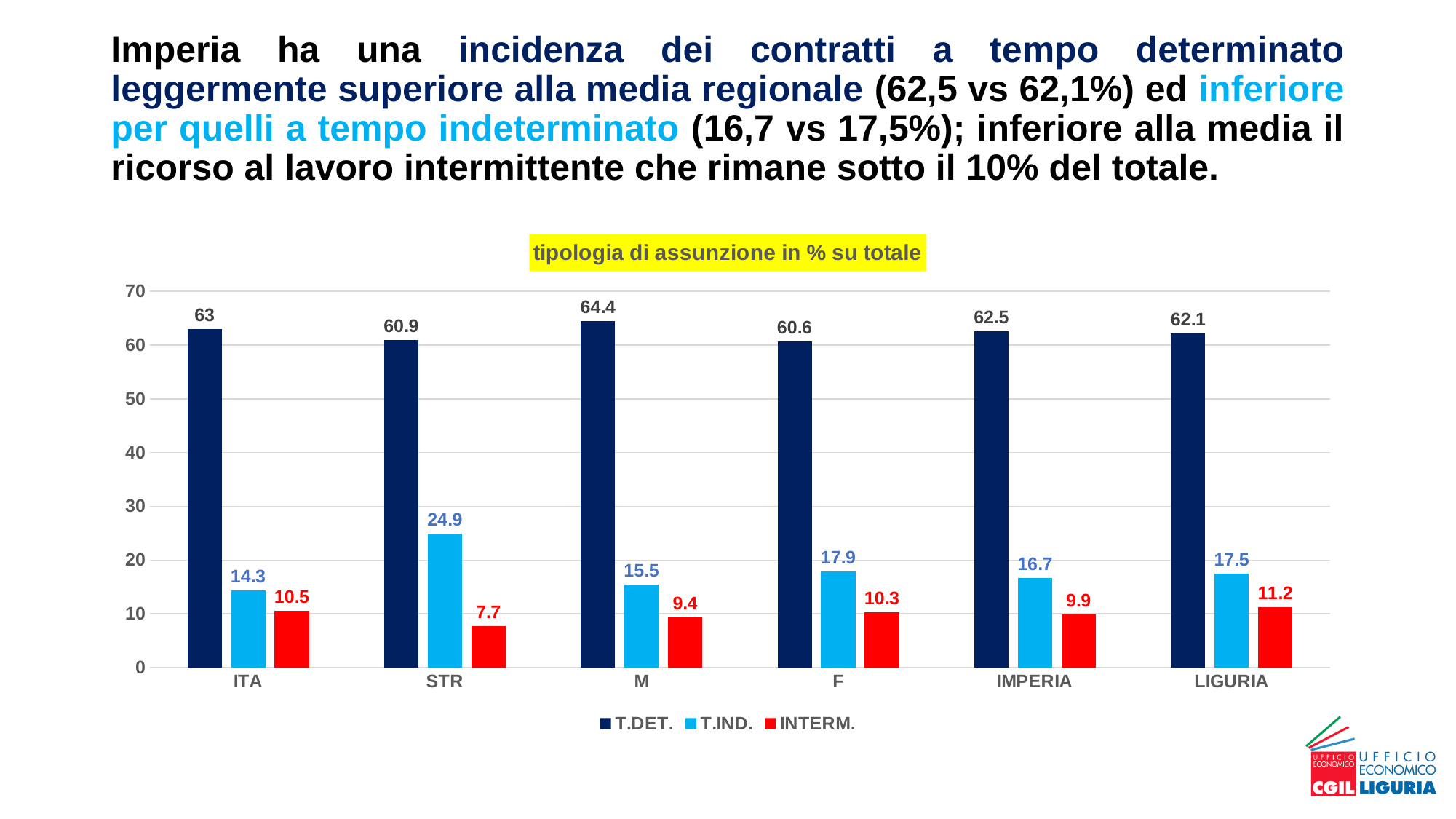
Is the T.IND. value for STR greater or less than 20? greater Which category has the highest T.DET. value? M What kind of chart is shown? bar chart Which category has the lowest INTERM. value? STR What is the T.DET. value for IMPERIA? 62.5 What is the T.IND. value for STR? 24.9 How many categories are shown on the x axis? 6 Which is larger, the INTERM. value for ITA or for F? ITA What is the INTERM. value for LIGURIA? 11.2 What is the title of the chart? tipologia di assunzione in % su totale How many series does the legend list? 3 What is the difference between the T.IND. values for LIGURIA and IMPERIA? 0.8